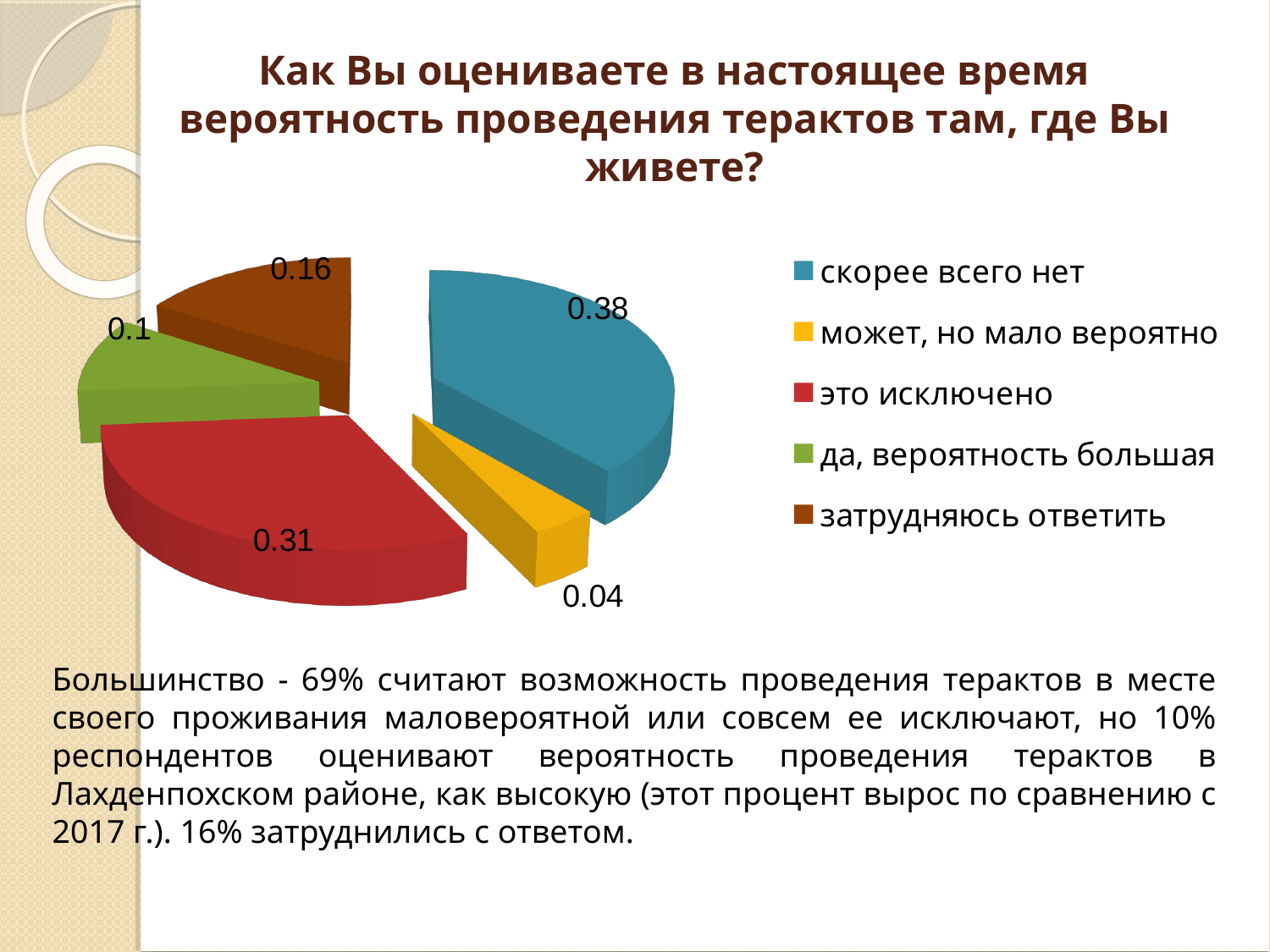
Which is larger, the value for "затрудняюсь ответить" or the value for "да, вероятность большая"? затрудняюсь ответить What colour is the slice for "это исключено"? red What is the value for "может, но мало вероятно"? 0.04 What kind of chart is shown on the slide? pie chart What is the value for "затрудняюсь ответить"? 0.16 What is the value for "это исключено"? 0.31 Which category has the smallest slice? может, но мало вероятно How many categories does the legend list? 5 What is the value for "да, вероятность большая"? 0.1 Which category has the largest slice? скорее всего нет What is the difference between the values for "скорее всего нет" and "это исключено"? 0.07 What is the value for "скорее всего нет"? 0.38